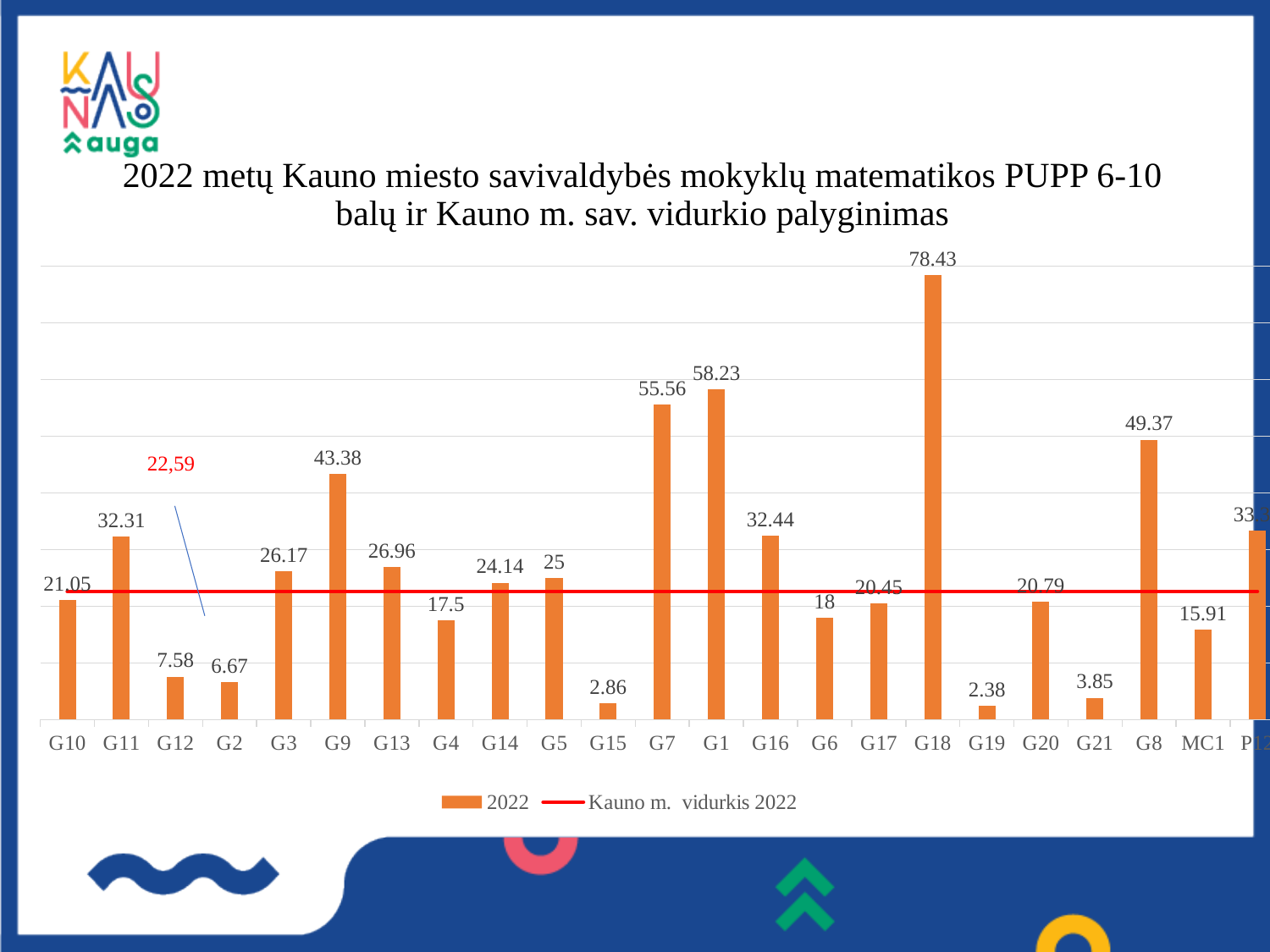
What is the difference between the values for G8 and G9? 5.99 Which category has the highest value? G18 What is the value for G18? 78.43 How many series does the legend list? 2 What is the difference between the values for G1 and G7? 2.67 What value is shown for the red line labelled 'Kauno m. vidurkis 2022'? 22,59 What kind of chart is shown on the slide? Bar and line chart (bars with a horizontal average line) What is the value for G9? 43.38 Which category has the lowest value? G19 What is the value for G4? 17.5 What is the value for G15? 2.86 Which is larger, the value for G8 or the value for G9? G8